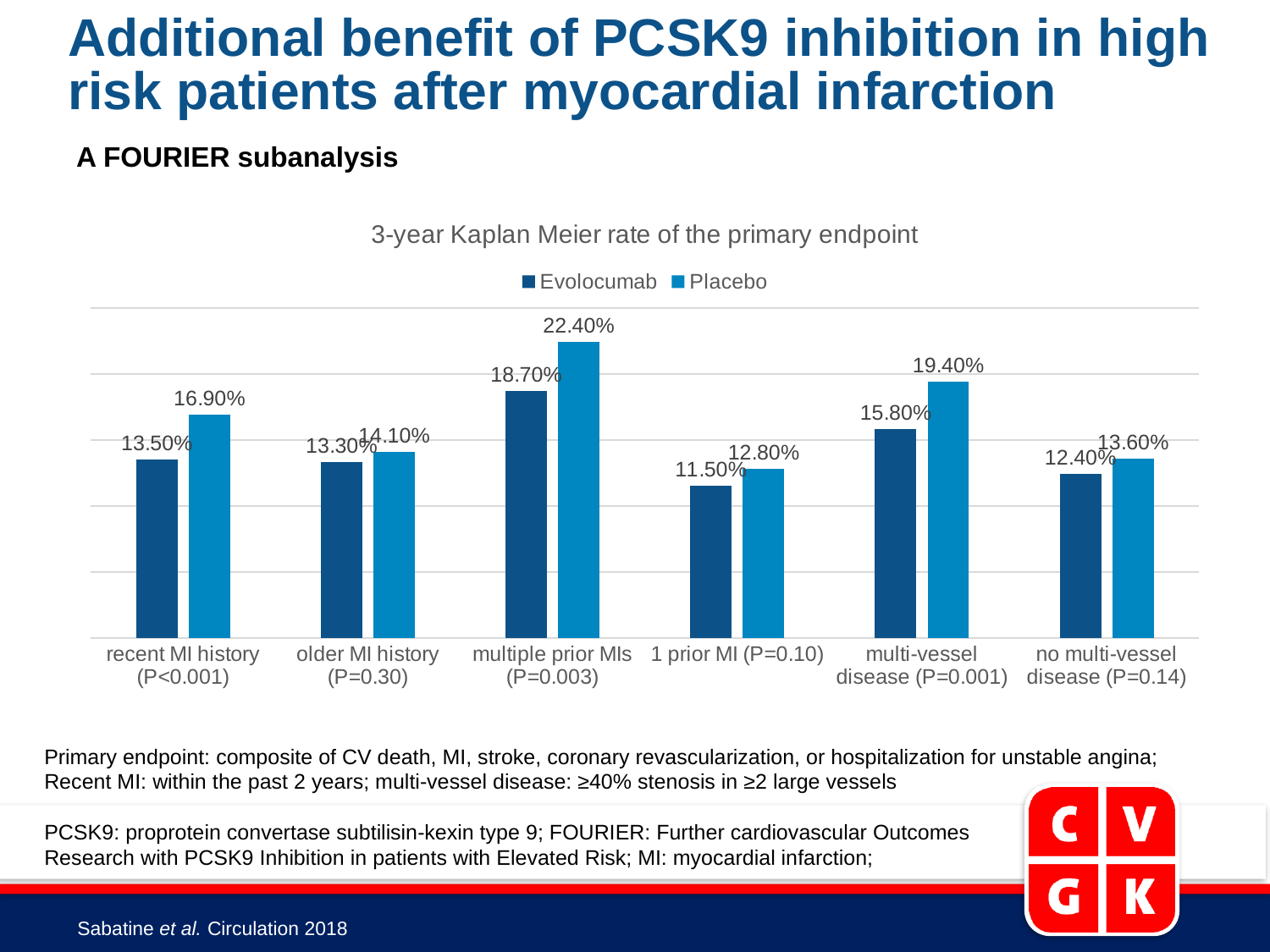
What is the difference between the Placebo and Evolocumab values for recent MI history (P<0.001)? 3.40% How many categories are shown on the x axis? 6 How many series does the legend list? 2 Which is larger for older MI history (P=0.30): the Evolocumab value or the Placebo value? Placebo What kind of chart is shown on the slide? bar chart Which category has the lowest Evolocumab value? 1 prior MI (P=0.10) What is the Placebo value for multiple prior MIs (P=0.003)? 22.40% What is the difference between the Placebo and Evolocumab values for multi-vessel disease (P=0.001)? 3.60% Which category has the highest Placebo value? multiple prior MIs (P=0.003) What is the Evolocumab value for recent MI history (P<0.001)? 13.50% What is the Placebo value for multi-vessel disease (P=0.001)? 19.40% What is the Evolocumab value for 1 prior MI (P=0.10)? 11.50%